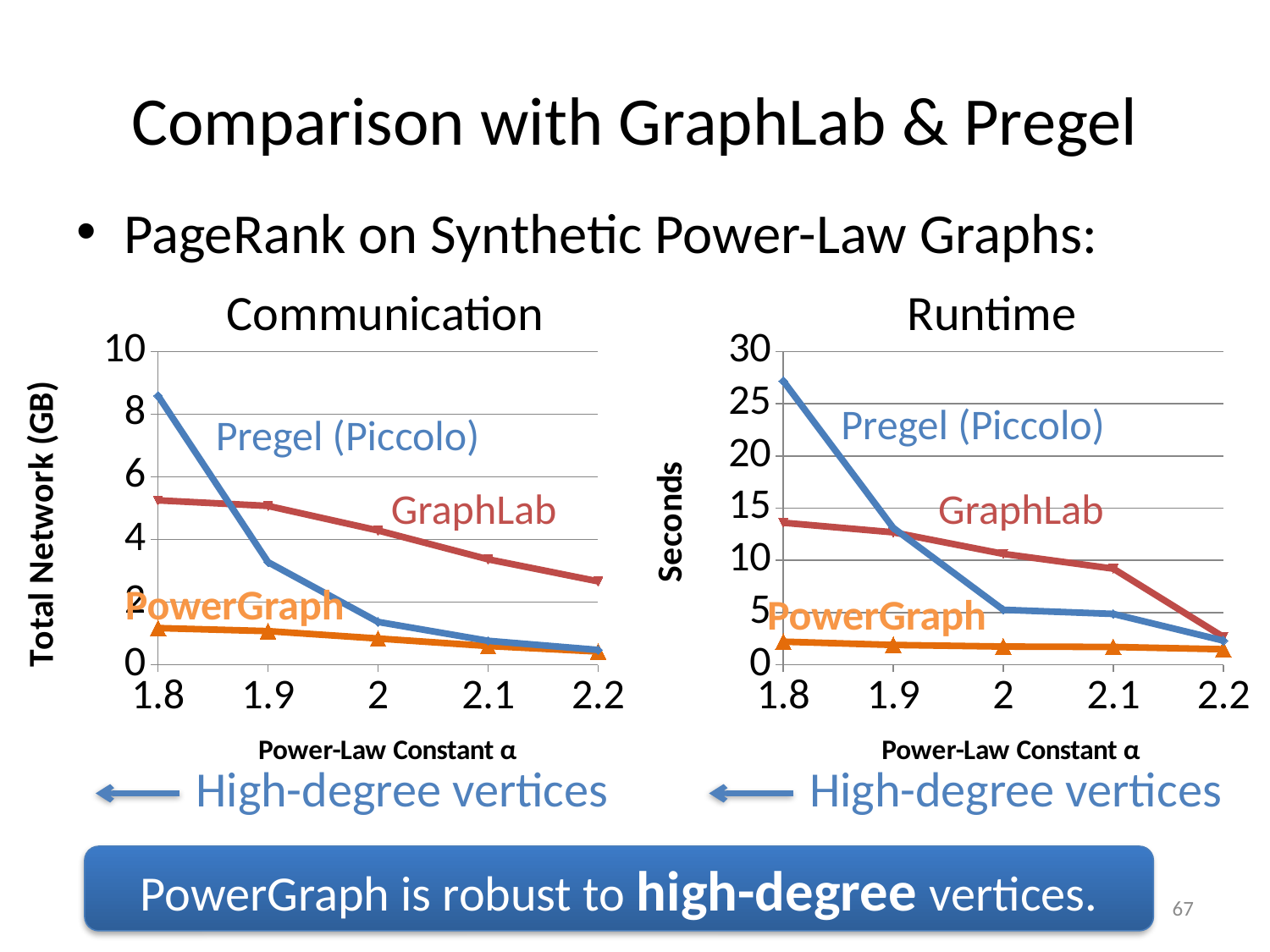
In the Runtime chart, is the value for GraphLab at α = 1.8 greater or less than 15? less In the Runtime chart, does the Pregel (Piccolo) line rise or fall as α increases from 1.8 to 2.2? fall In the Runtime chart, which series has the lowest value at α = 1.8? PowerGraph In the Communication chart, which series has the highest value at α = 1.8? Pregel (Piccolo) How many values of the Power-Law Constant α are plotted on the x axis of the Runtime chart? 5 In the Communication chart, which is larger at α = 2.2: GraphLab or Pregel (Piccolo)? GraphLab In the Communication chart, is the value for Pregel (Piccolo) at α = 1.8 greater or less than 8? greater How many series are plotted in the Communication chart? 3 What is the y-axis label of the Communication chart? Total Network (GB) In the Communication chart, is the value for PowerGraph at α = 1.8 greater or less than 2? less What kind of chart is the Communication chart? line chart